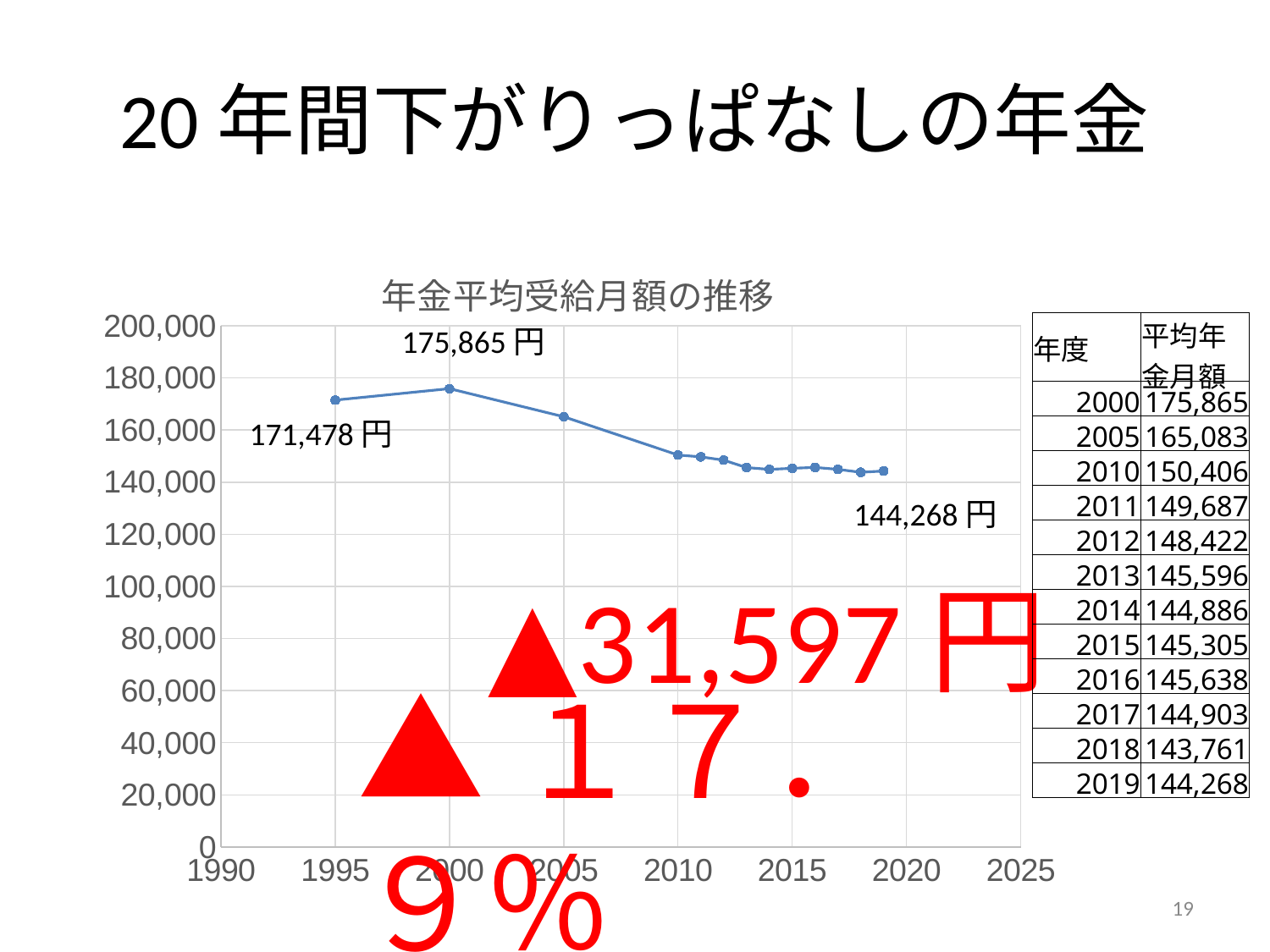
What is the value for 1995 in the chart 年金平均受給月額の推移? 171,478 円 Which year has the highest value in the chart 年金平均受給月額の推移? 2000 What is the difference between the 2000 value and the 1995 value in the chart? 4,387 円 According to the table next to the chart, what is the 平均年金月額 for 2010? 150,406 Which is larger in the chart, the value for 1995 or the value for 2019? 1995 What is the difference between the 2000 value and the 2019 value in the chart? 31,597 円 What is the value for 2019 in the chart 年金平均受給月額の推移? 144,268 円 What kind of chart is shown on the slide? line chart Is the value for 2005 in the chart greater or less than 160,000? greater What is the value for 2000 in the chart 年金平均受給月額の推移? 175,865 円 How many data points are plotted on the line in the chart? 13 Do the values in the chart generally rise or fall from 2000 to 2019? fall